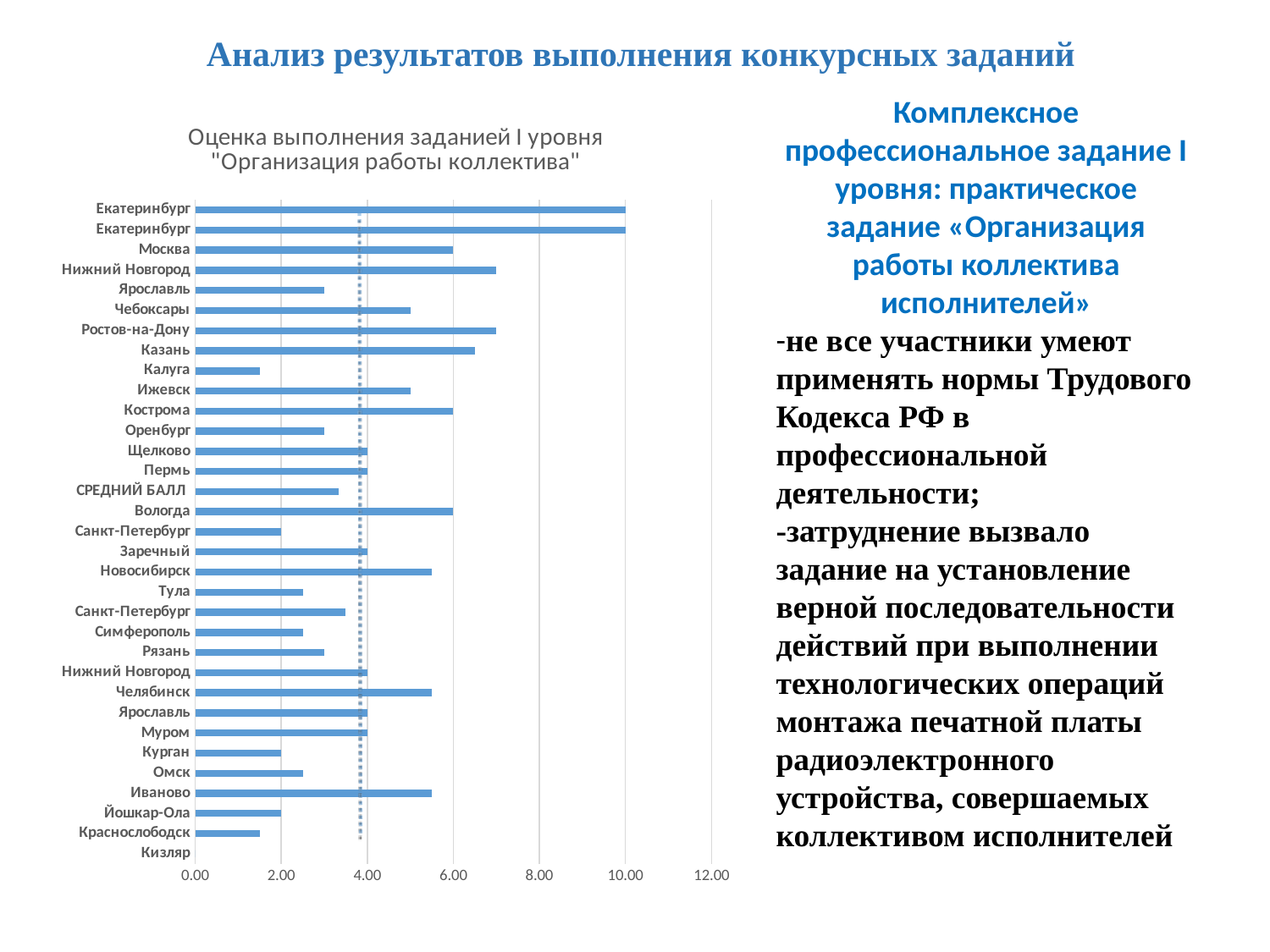
What is the value for Москва? 6.00 What is the title of the chart? Оценка выполнения заданией I уровня "Организация работы коллектива" Is the value for Калуга greater or less than 2.00? less What is the difference between the values for Москва and Курган? 4.00 Which is larger, the value for Вологда or the value for Йошкар-Ола? Вологда Is the value for Казань greater or less than 6.00? greater What is the value for Муром? 4.00 Which category has the lowest value in the chart? Кизляр What is the value for Курган? 2.00 What kind of chart is shown on the slide? bar chart Which city has the highest value in the chart? Екатеринбург What is the value for Кострома? 6.00